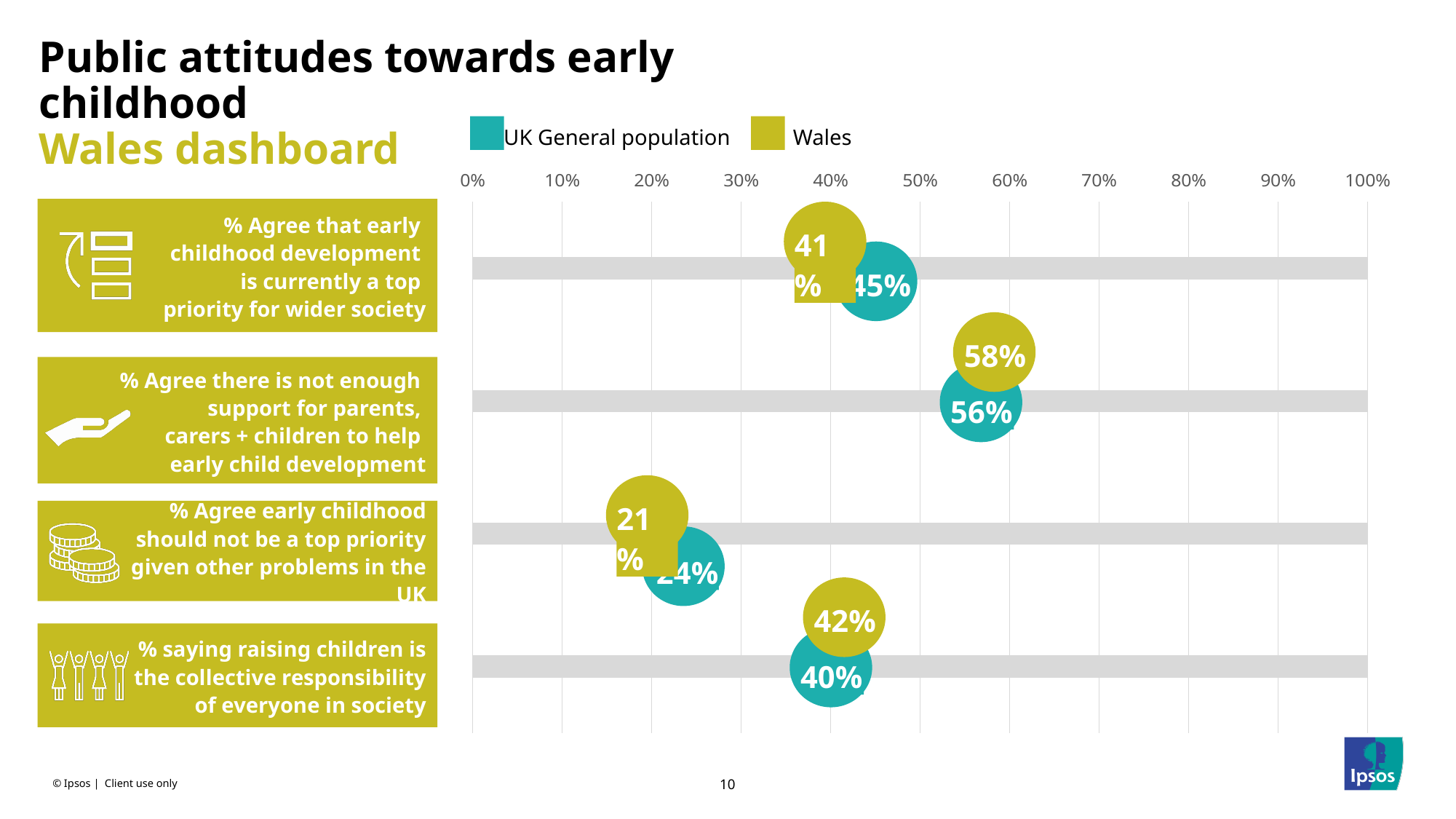
What is the difference between the UK General population and Wales values for agreeing early childhood development is currently a top priority for wider society? 4 percentage points Which colour represents Wales in the chart? Yellow What is the UK General population value for agreeing early childhood should not be a top priority given other problems in the UK? 24% For the statement that raising children is the collective responsibility of everyone in society, which is larger: the Wales value or the UK General population value? Wales What percentage of the Wales sample say raising children is the collective responsibility of everyone in society? 42% What is the Wales value for agreeing there is not enough support for parents, carers and children to help early child development? 58% Which statement has the lowest value for Wales? % Agree early childhood should not be a top priority given other problems in the UK Which statement has the highest value for the UK General population? % Agree there is not enough support for parents, carers + children to help early child development What percentage of the Wales sample agree that early childhood development is currently a top priority for wider society? 41% What percentage of the UK General population agree that early childhood development is currently a top priority for wider society? 45% How many series does the legend list? 2 How many statements (rows) are plotted on the chart? 4